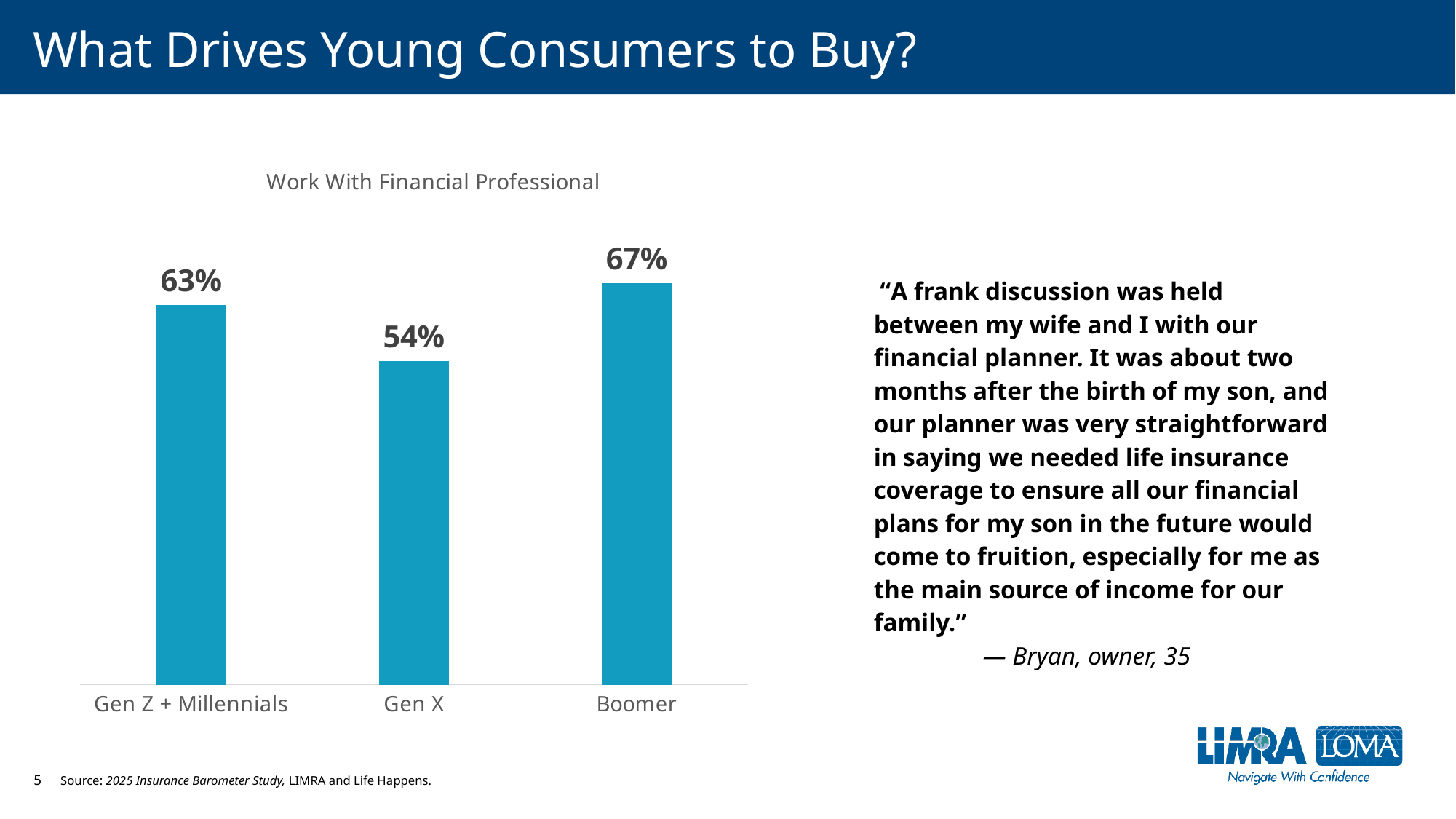
What colour are the bars in the Work With Financial Professional chart? Blue Which is larger in the Work With Financial Professional chart: Gen Z + Millennials or Boomer? Boomer What is the difference between the Gen Z + Millennials and Gen X values in the Work With Financial Professional chart? 9% Which category has the lowest value in the Work With Financial Professional chart? Gen X What is the title of the chart on the slide? Work With Financial Professional What kind of chart is the Work With Financial Professional chart? Bar chart What is the value for Boomer in the Work With Financial Professional chart? 67% Which category has the highest value in the Work With Financial Professional chart? Boomer What is the value for Gen Z + Millennials in the Work With Financial Professional chart? 63% What is the value for Gen X in the Work With Financial Professional chart? 54% What is the difference between the Boomer and Gen X values in the Work With Financial Professional chart? 13% How many categories are shown in the Work With Financial Professional chart? 3